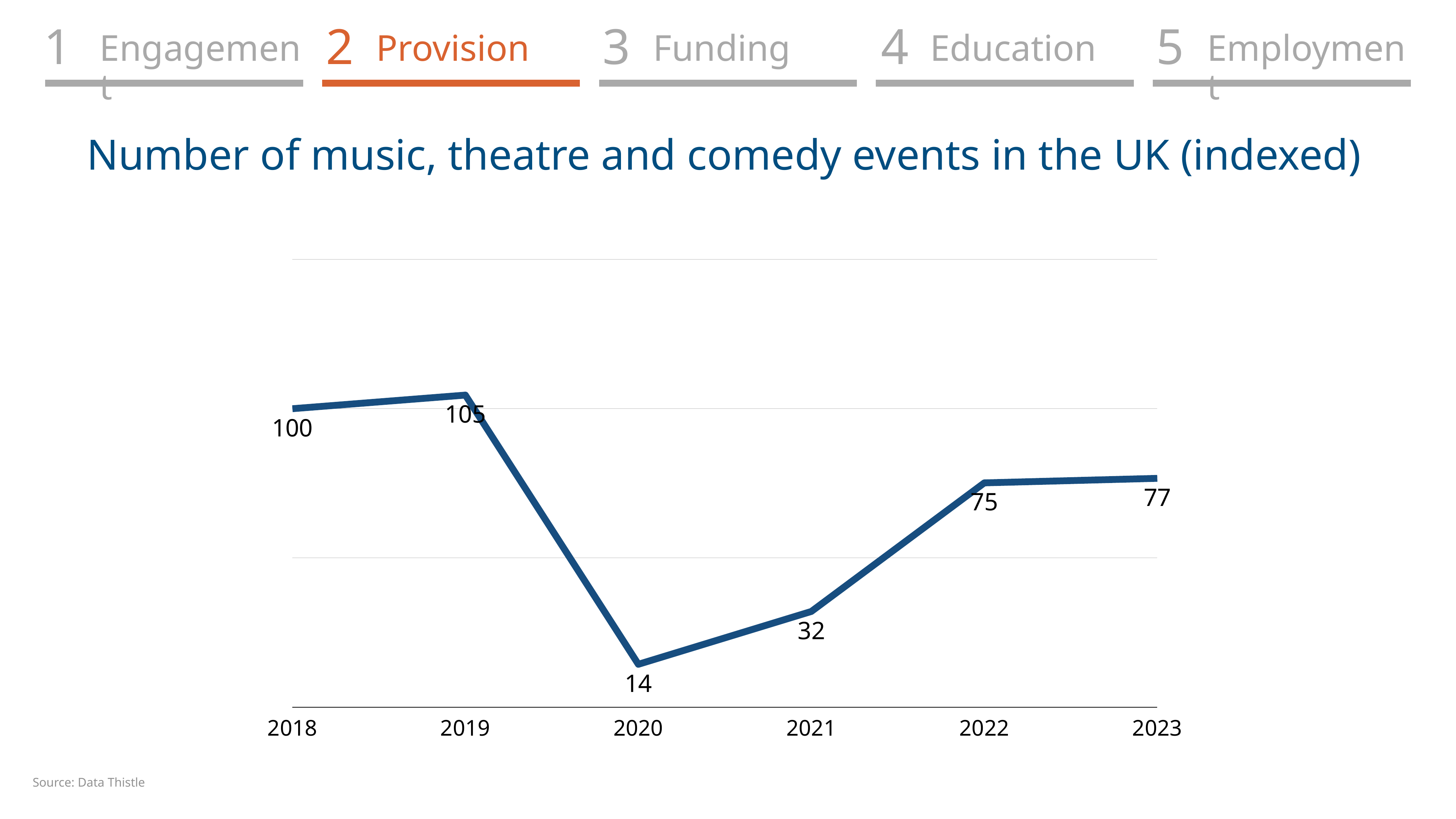
What is the indexed value for 2020? 14 What is the difference between the 2019 value and the 2020 value? 91 Do the values rise or fall from 2020 to 2023? rise What is the indexed value for 2018? 100 What is the difference between the 2022 value and the 2021 value? 43 Which year has the lowest indexed number of events? 2020 Which is larger, the value for 2018 or the value for 2023? 2018 Which year has the highest indexed number of events? 2019 What is the title of the chart? Number of music, theatre and comedy events in the UK (indexed) How many years are plotted on the chart? 6 What is the indexed value for 2023? 77 What kind of chart is shown on the slide? line chart